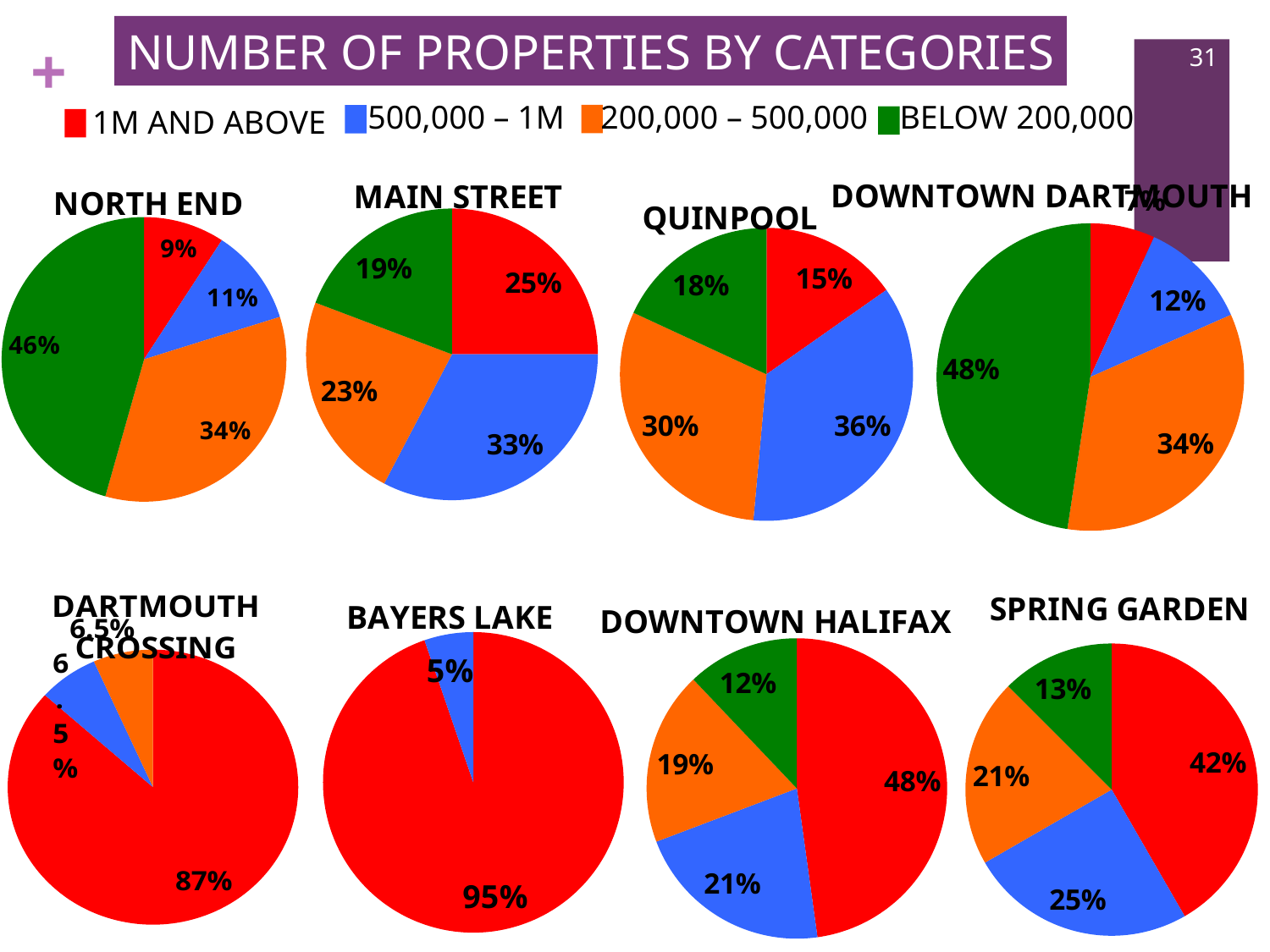
In the North End pie chart, what share of properties is in the BELOW 200,000 category? 46% In the Bayers Lake pie chart, what share of properties is in the 1M AND ABOVE category? 95% In the Downtown Dartmouth pie chart, what share of properties is in the 200,000 – 500,000 category? 34% Which colour represents the 1M AND ABOVE category in the legend? Red In the Quinpool pie chart, which category has the largest share? 500,000 – 1M How many categories does the legend list? 4 How many pie charts are shown on the slide? 8 In the Downtown Halifax pie chart, which category has the smallest share? BELOW 200,000 In the Quinpool pie chart, which is larger: the 200,000 – 500,000 share or the BELOW 200,000 share? 200,000 – 500,000 In the Main Street pie chart, what share of properties is in the 500,000 – 1M category? 33% What kind of chart is used for each location on this slide? Pie chart In the Spring Garden pie chart, what is the difference between the 1M AND ABOVE share and the 500,000 – 1M share? 17%